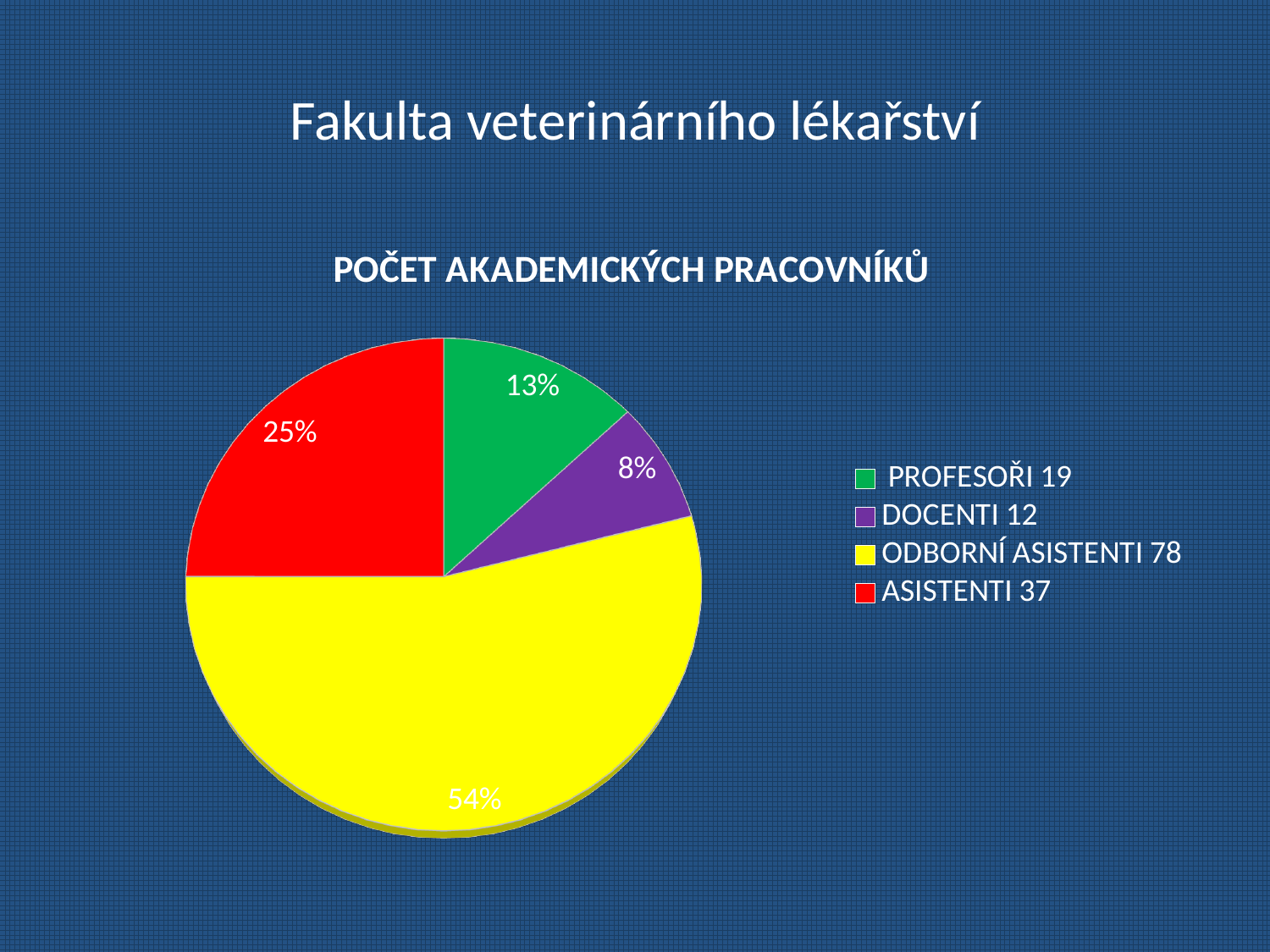
Which slice is larger, ASISTENTI or PROFESOŘI? ASISTENTI What colour is the slice for ASISTENTI? red Which category has the smallest slice of the pie? DOCENTI What kind of chart is shown on the slide? pie chart What percentage share does the ASISTENTI slice have? 25% What percentage share does the DOCENTI slice have? 8% Which category has the largest slice of the pie? ODBORNÍ ASISTENTI What percentage share does the PROFESOŘI slice have? 13% What is the title of the chart? POČET AKADEMICKÝCH PRACOVNÍKŮ What is the difference in percentage points between the ODBORNÍ ASISTENTI slice and the ASISTENTI slice? 29 percentage points How many slices does the pie chart have? 4